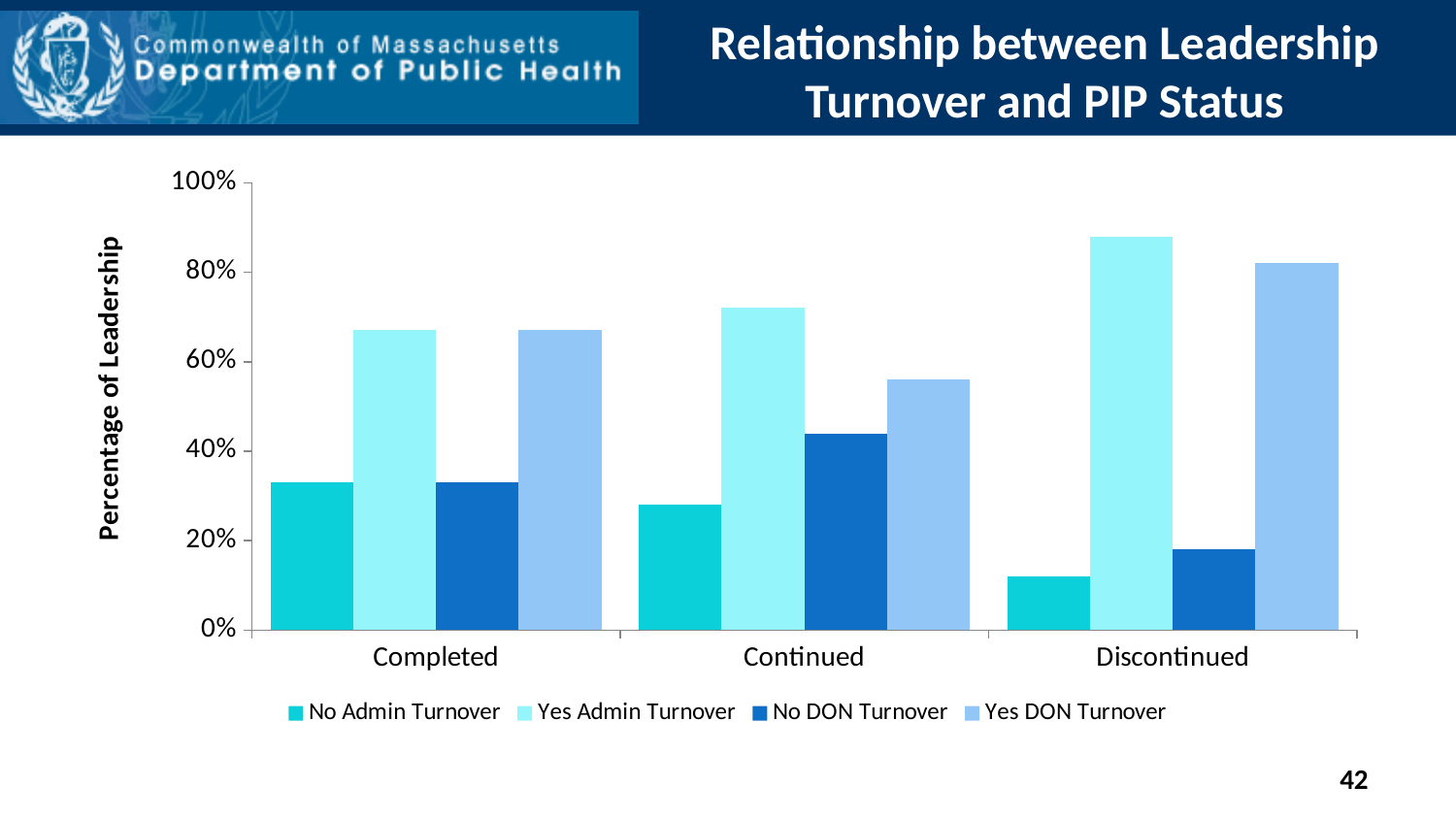
What kind of chart is shown on the slide? bar chart How many series does the legend list? 4 Is the value for Yes Admin Turnover in the Discontinued category greater or less than 80%? greater What is the title of the chart on the slide? Relationship between Leadership Turnover and PIP Status Do the values for No Admin Turnover rise or fall from Completed to Discontinued? fall Which category has the highest value for Yes DON Turnover? Discontinued How many categories are shown on the x axis? 3 Which category has the lowest value for No Admin Turnover? Discontinued What is the label on the vertical axis? Percentage of Leadership Is the value for No DON Turnover in the Continued category greater or less than 40%? greater Is the value for No Admin Turnover in the Discontinued category greater or less than 20%? less In the Continued category, which is larger: Yes Admin Turnover or Yes DON Turnover? Yes Admin Turnover